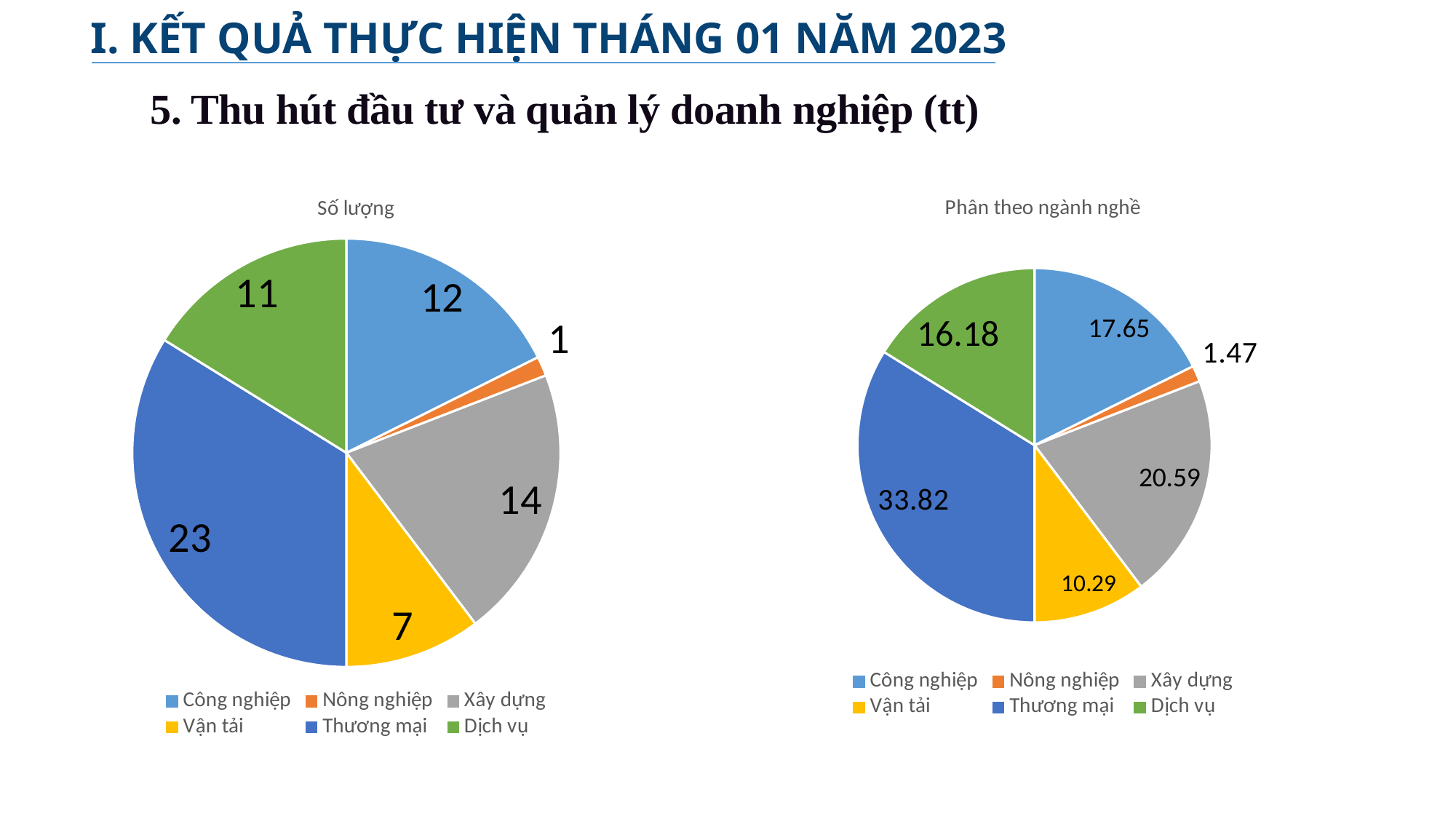
In the "Phân theo ngành nghề" chart, which category has the smallest slice? Nông nghiệp In the "Số lượng" chart, what is the value for Thương mại? 23 In the "Số lượng" chart, which is larger, Xây dựng or Dịch vụ? Xây dựng In the "Số lượng" chart, which category has the largest slice? Thương mại How many categories does the "Số lượng" chart show? 6 In the "Số lượng" chart, which colour represents Vận tải? Yellow What kind of chart is the "Phân theo ngành nghề" chart? Pie chart In the "Số lượng" chart, what is the difference between the values for Thương mại and Công nghiệp? 11 In the "Phân theo ngành nghề" chart, what is the value for Vận tải? 10.29 In the "Số lượng" chart, what is the value for Xây dựng? 14 In the "Phân theo ngành nghề" chart, what is the value for Dịch vụ? 16.18 In the "Phân theo ngành nghề" chart, what is the difference between the values for Xây dựng and Công nghiệp? 2.94